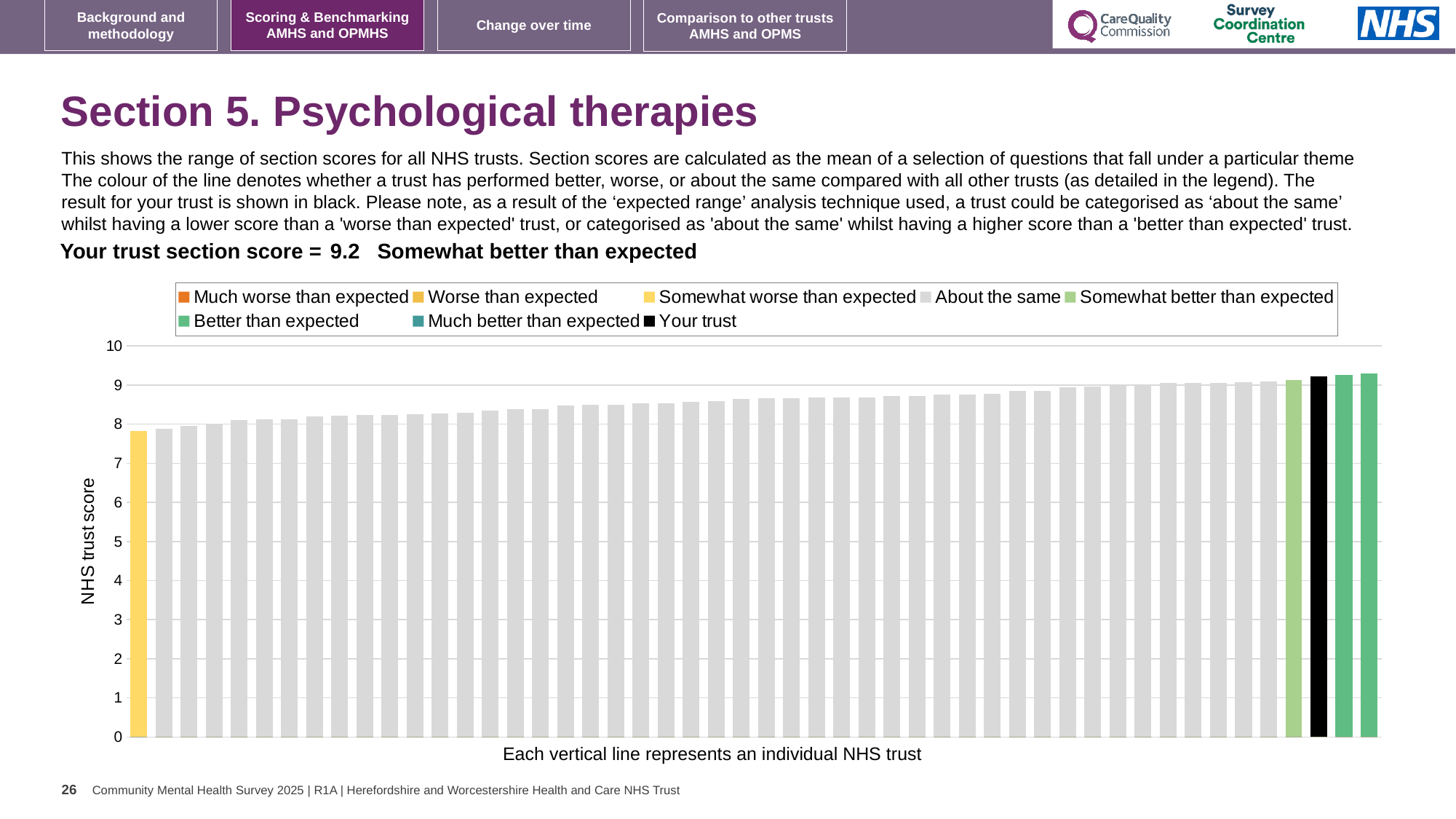
What colour is the bar representing your trust? black Is the value for the rightmost bar greater or less than 9? greater What is the section score for your trust shown on the slide? 9.2 What kind of chart is shown on the slide? bar chart Is the value for the leftmost bar greater or less than 8? less Is the value for the black bar (your trust) greater or less than 9? greater Which category does your trust's section score fall into according to the slide? Somewhat better than expected Which bar is taller, the leftmost bar or the rightmost bar? the rightmost bar Do the bar values rise or fall from left to right along the x axis? rise How many entries does the chart legend list? 8 What is the label on the vertical axis of the chart? NHS trust score